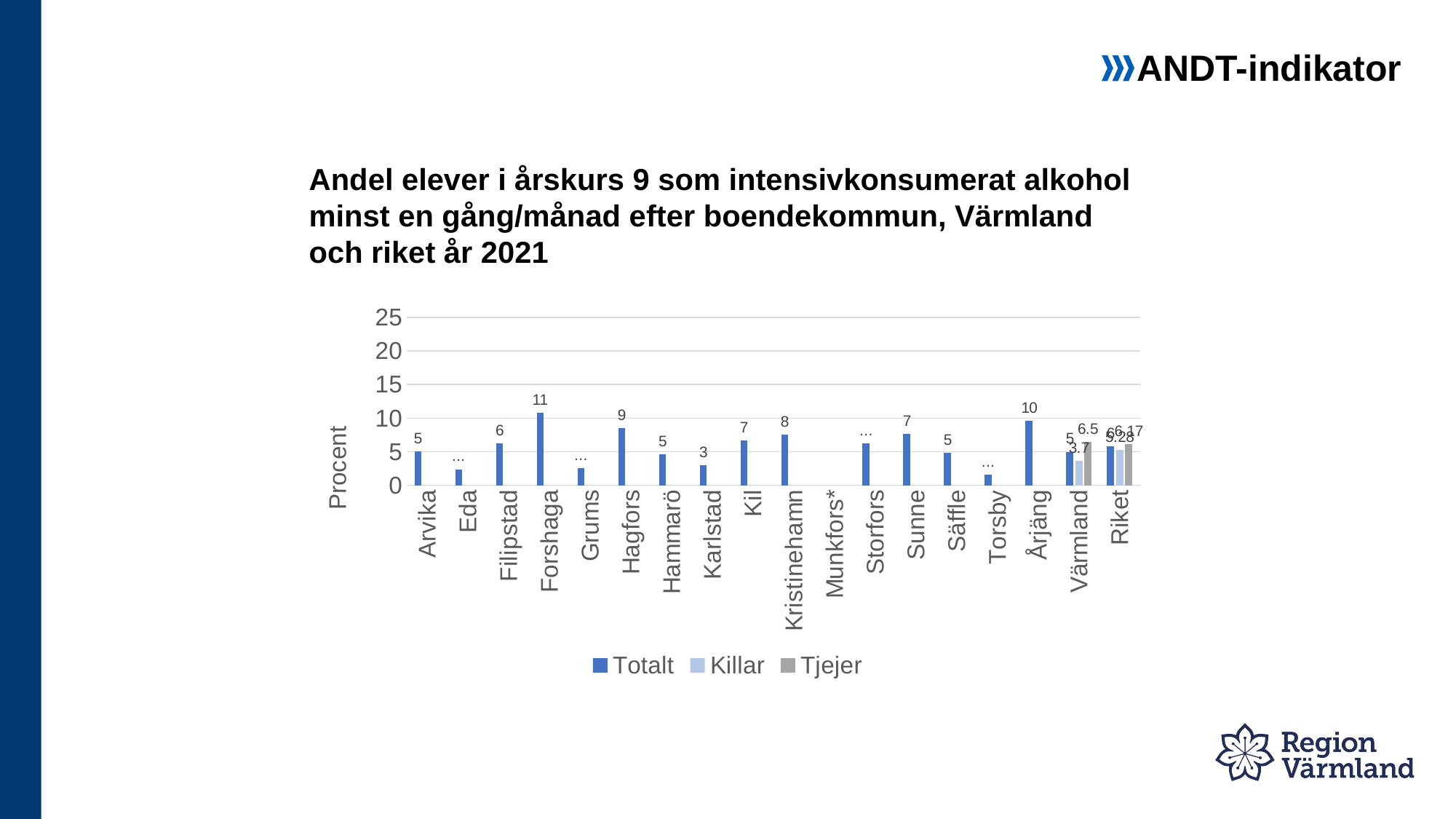
What is the difference between the Tjejer and Killar values for Värmland? 2.8 What is the difference between the Totalt values for Forshaga and Karlstad? 8 What is the Totalt value for Forshaga? 11 What is the Tjejer value for Värmland? 6.5 Which municipality has the highest Totalt value? Forshaga Is the Totalt value for Torsby greater or less than 5? less What is the Totalt value for Karlstad? 3 What kind of chart is shown on the slide? bar chart What is the label on the vertical axis of the chart? Procent What is the Killar value for Värmland? 3.7 Which has a higher Totalt value, Hagfors or Kristinehamn? Hagfors How many series does the legend list? 3